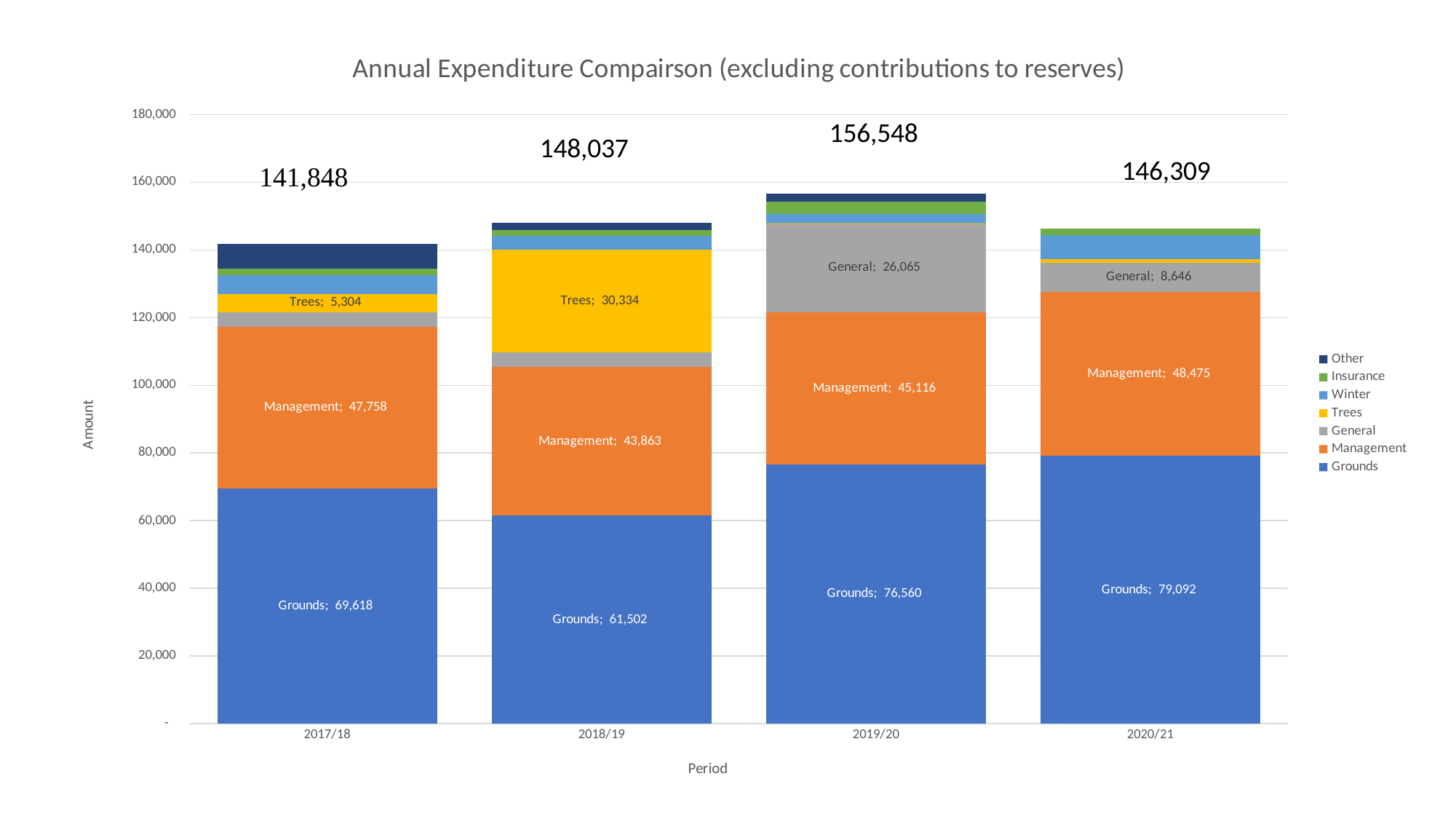
Which period has the lowest total expenditure? 2017/18 Which period has the larger Management value, 2017/18 or 2018/19? 2017/18 What is the value for Management in 2020/21? 48,475 What is the total expenditure shown for 2019/20? 156,548 What is the value for Trees in 2018/19? 30,334 How many series does the legend list? 7 How many periods are shown on the x axis? 4 How much higher is the Grounds value in 2020/21 than in 2017/18? 9,474 What is the value for Grounds in 2017/18? 69,618 What is the difference between the total for 2019/20 and the total for 2017/18? 14,700 What is the value for General in 2019/20? 26,065 Which period has the highest total expenditure? 2019/20